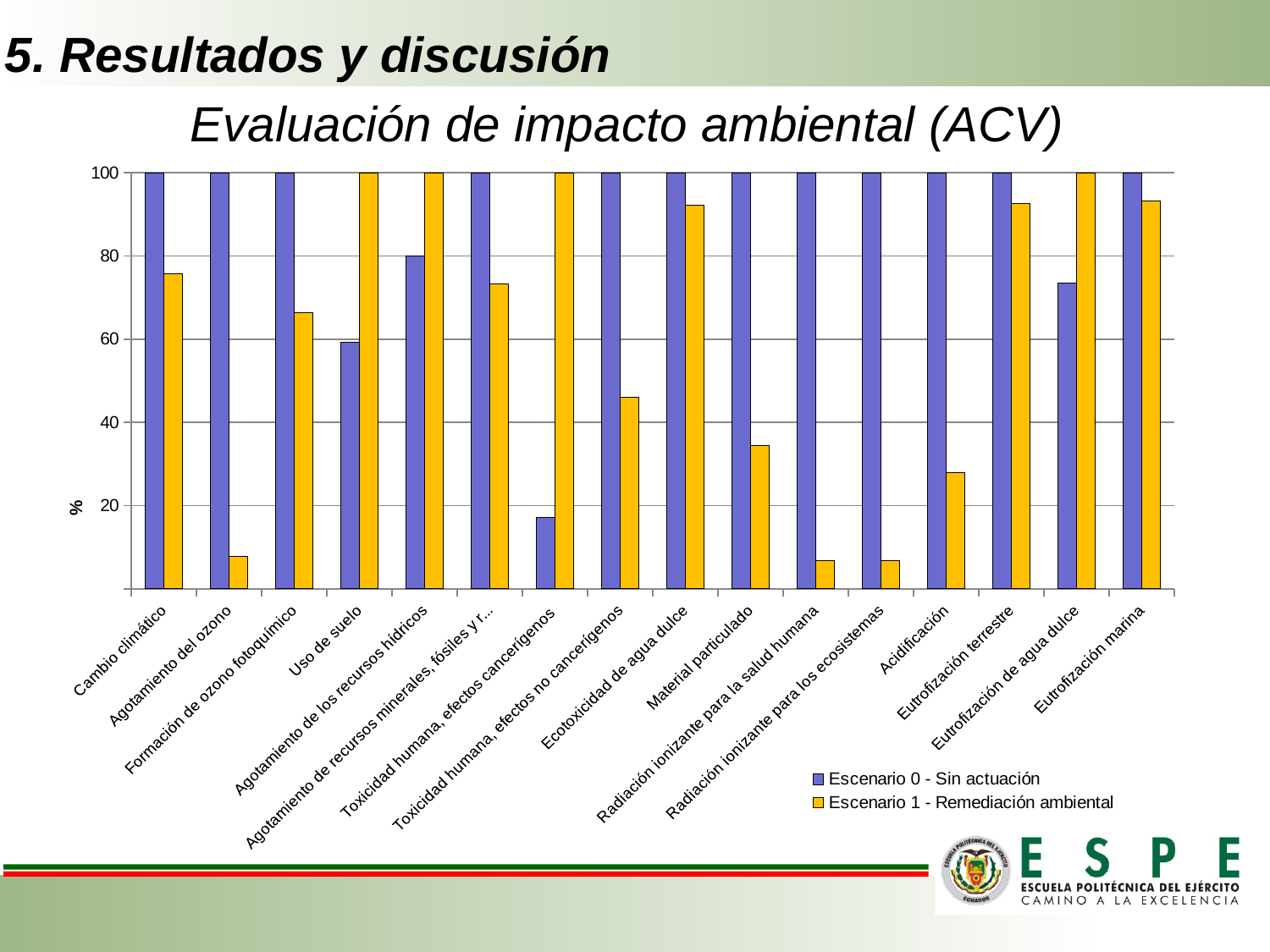
Is the value for Agotamiento del ozono in the Escenario 1 - Remediación ambiental series greater or less than 20? less What is the title of the chart? Evaluación de impacto ambiental (ACV) Is the value for Uso de suelo in the Escenario 0 - Sin actuación series greater or less than 40? greater How many series does the legend list? 2 How many categories are shown on the x axis of the chart? 16 What is the value for Uso de suelo in the Escenario 1 - Remediación ambiental series? 100 For Acidificación, which series has the larger value: Escenario 0 - Sin actuación or Escenario 1 - Remediación ambiental? Escenario 0 - Sin actuación Is the value for Material particulado in the Escenario 1 - Remediación ambiental series greater or less than 40? less For Eutrofización de agua dulce, which series has the larger value: Escenario 0 - Sin actuación or Escenario 1 - Remediación ambiental? Escenario 1 - Remediación ambiental What is the value for Cambio climático in the Escenario 0 - Sin actuación series? 100 What kind of chart is shown on the slide? Bar chart